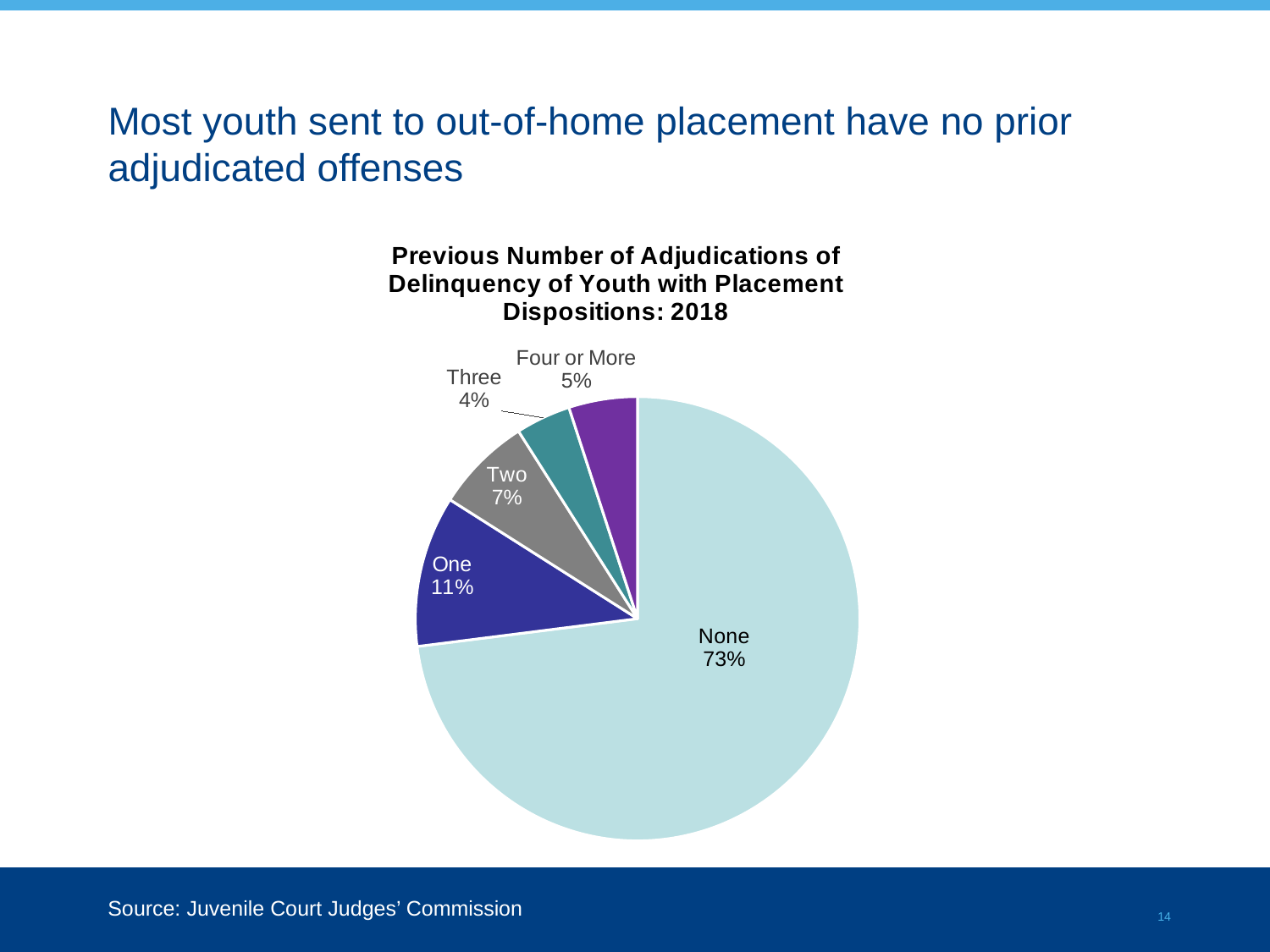
What kind of chart is shown on the slide? pie chart Which is larger, the 'Two' slice or the 'Four or More' slice? Two Which category has the smallest slice of the pie? Three Which category has the largest slice of the pie? None What share of the pie is 'Four or More'? 5% What is the difference in percentage points between the 'None' slice and the 'One' slice? 62 How many categories are shown in the pie chart? 5 What percentage is shown for 'Three' previous adjudications? 4% What is the value shown for the 'Two' slice? 7% What share of youth with placement dispositions had no previous adjudications? 73% What year does the chart title say the data is for? 2018 What percentage of the pie is labelled 'One'? 11%